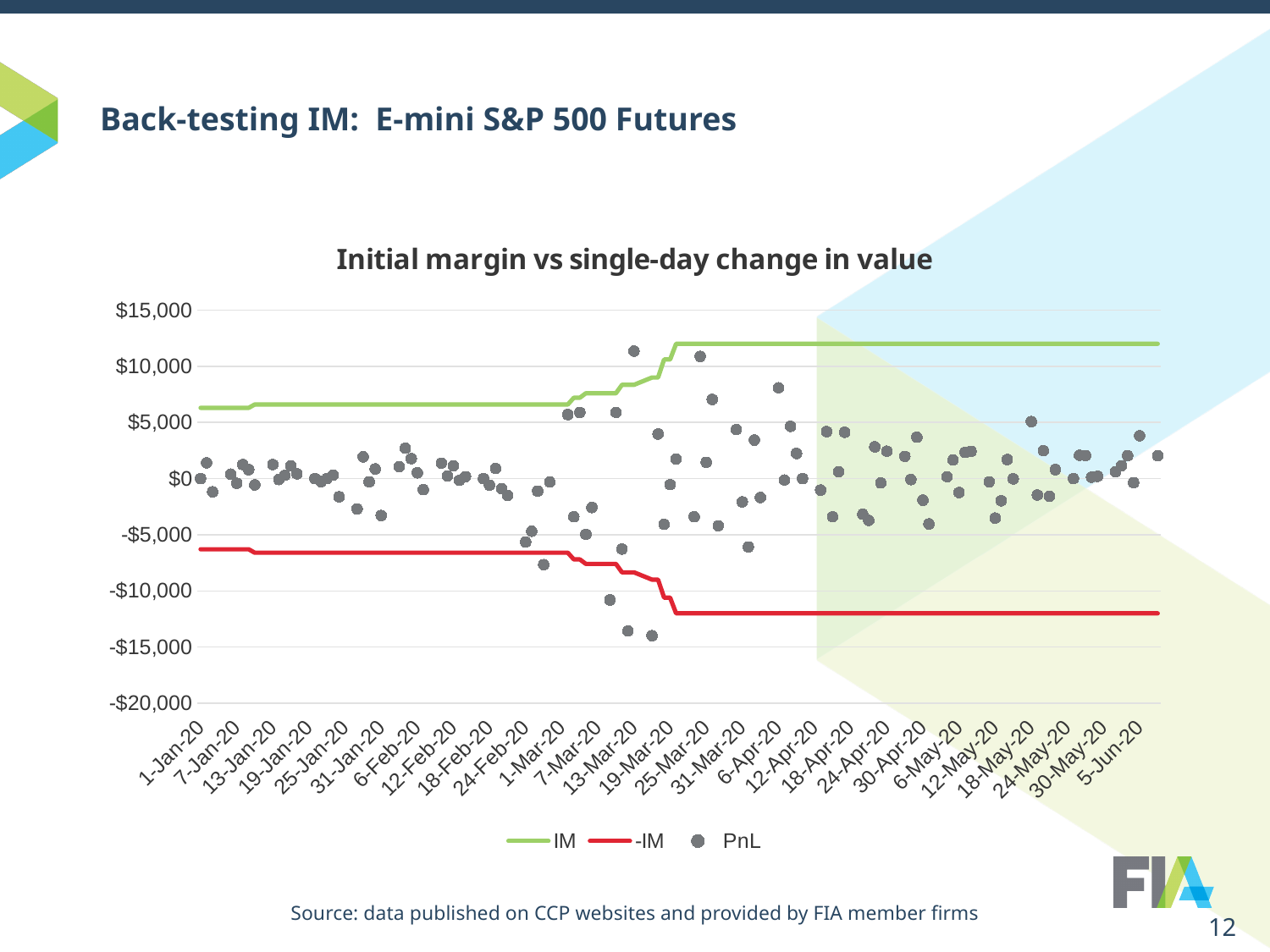
Is the -IM value at 1-Jan-20 greater or less than -$10,000? greater What are the series names listed in the chart legend? IM, -IM, PnL Is the IM value at 1-Jan-20 greater or less than $5,000? greater What is the title of the chart? Initial margin vs single-day change in value Is the -IM value at 5-Jun-20 greater or less than -$10,000? less Does the -IM line rise or fall from 1-Jan-20 to 5-Jun-20? fall What is the highest value shown on the vertical axis? $15,000 How many series does the chart legend list? 3 Which is larger at 5-Jun-20, the IM value or the -IM value? IM Does the IM line rise or fall from 1-Jan-20 to 5-Jun-20? rise